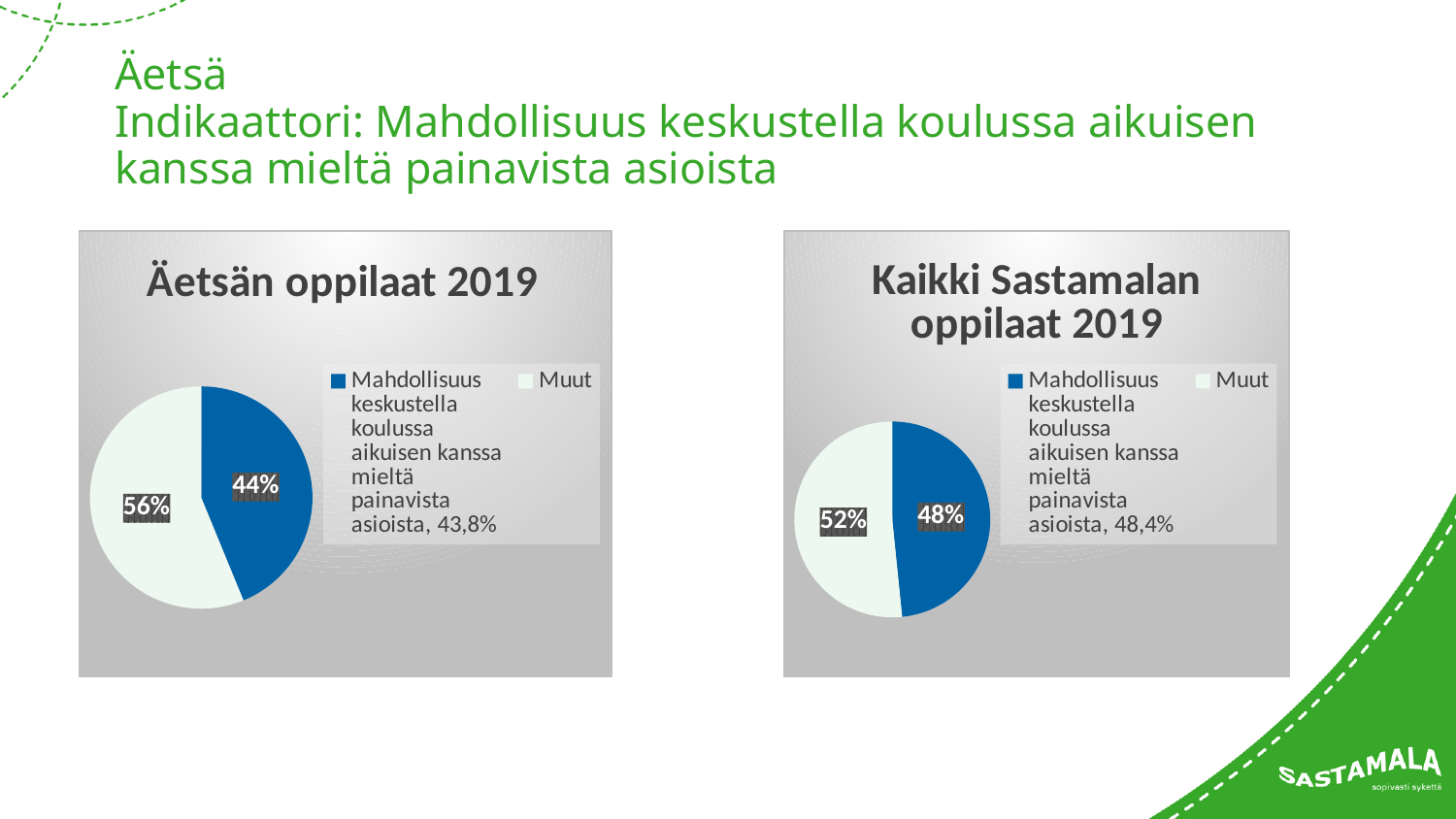
Which chart shows a larger "Mahdollisuus keskustella" slice, "Äetsän oppilaat 2019" or "Kaikki Sastamalan oppilaat 2019"? Kaikki Sastamalan oppilaat 2019 In the "Kaikki Sastamalan oppilaat 2019" chart, what percentage is shown for the "Muut" slice? 52% In the "Kaikki Sastamalan oppilaat 2019" chart, what is the difference in percentage points between the "Muut" slice and the "Mahdollisuus keskustella" slice? 4 In the "Äetsän oppilaat 2019" chart, what percentage is shown on the slice for "Mahdollisuus keskustella koulussa aikuisen kanssa mieltä painavista asioista"? 44% In the "Äetsän oppilaat 2019" chart, what exact value is given in the legend for the "Mahdollisuus keskustella" category? 43,8% In the "Kaikki Sastamalan oppilaat 2019" chart, which slice is the smallest? Mahdollisuus keskustella koulussa aikuisen kanssa mieltä painavista asioista In the "Äetsän oppilaat 2019" chart, which slice is the largest? Muut In the "Äetsän oppilaat 2019" chart, what is the difference in percentage points between the "Muut" slice and the "Mahdollisuus keskustella" slice? 12 In the "Äetsän oppilaat 2019" chart, what percentage is shown for the "Muut" slice? 56% In the "Kaikki Sastamalan oppilaat 2019" chart, what percentage is shown on the slice for "Mahdollisuus keskustella koulussa aikuisen kanssa mieltä painavista asioista"? 48% How many slices does the "Kaikki Sastamalan oppilaat 2019" pie chart have? 2 What kind of chart is the "Äetsän oppilaat 2019" chart? pie chart